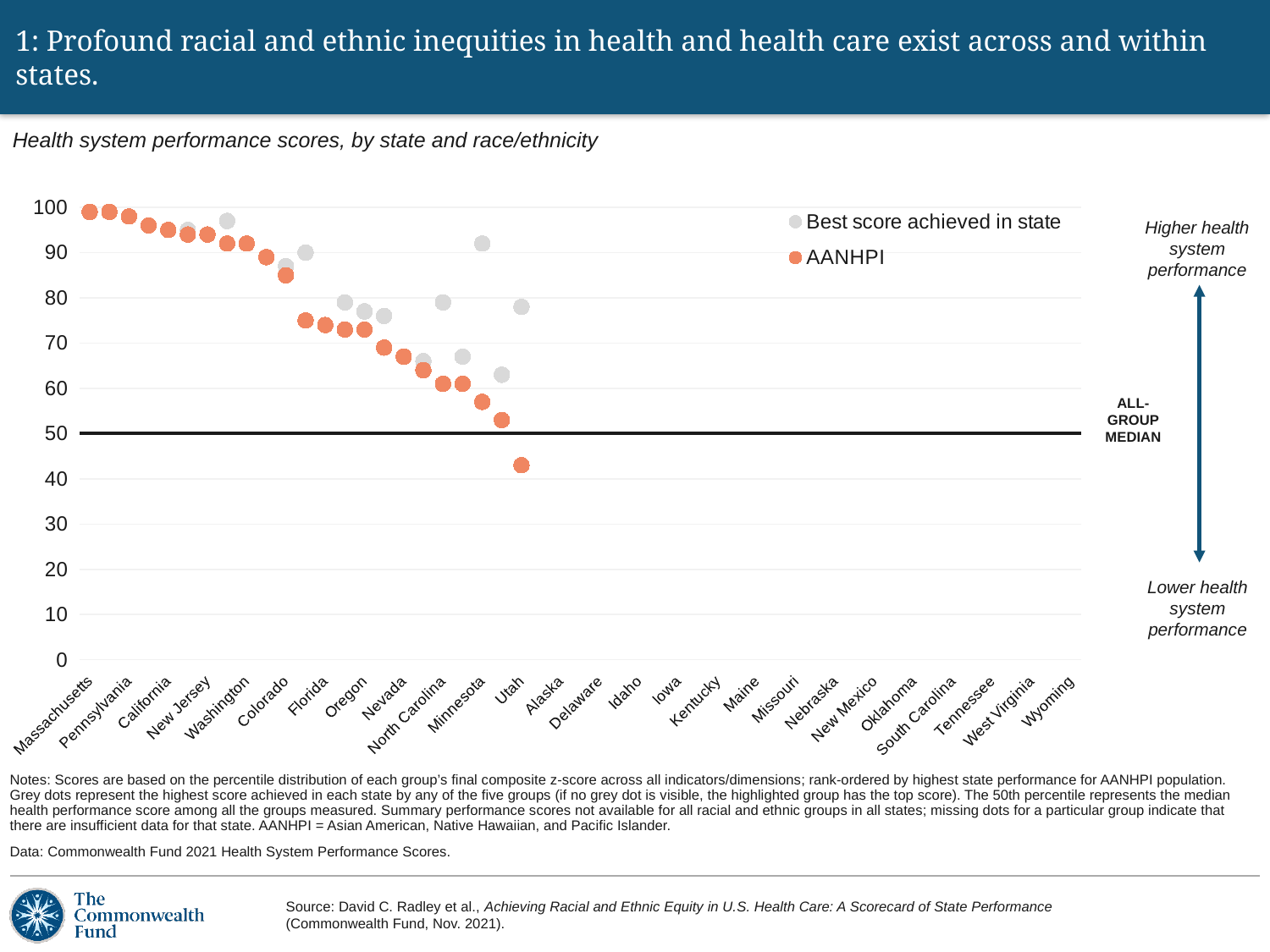
How many series does the legend list? 2 What kind of chart is shown on the slide? Scatter (dot) chart How many state names are labeled on the x axis? 26 What is the maximum value shown on the y axis? 100 Do the AANHPI scores rise or fall moving from left to right along the x axis? fall Which state is labeled first (leftmost) on the x axis? Massachusetts What are the two series named in the legend? Best score achieved in state; AANHPI Is the lowest AANHPI score plotted greater or less than 50? less What is the title of the chart? Health system performance scores, by state and race/ethnicity Is the AANHPI score for Massachusetts greater or less than 90? greater At what value is the horizontal 'ALL-GROUP MEDIAN' line drawn? 50 How many AANHPI dots fall below the all-group median line? 1